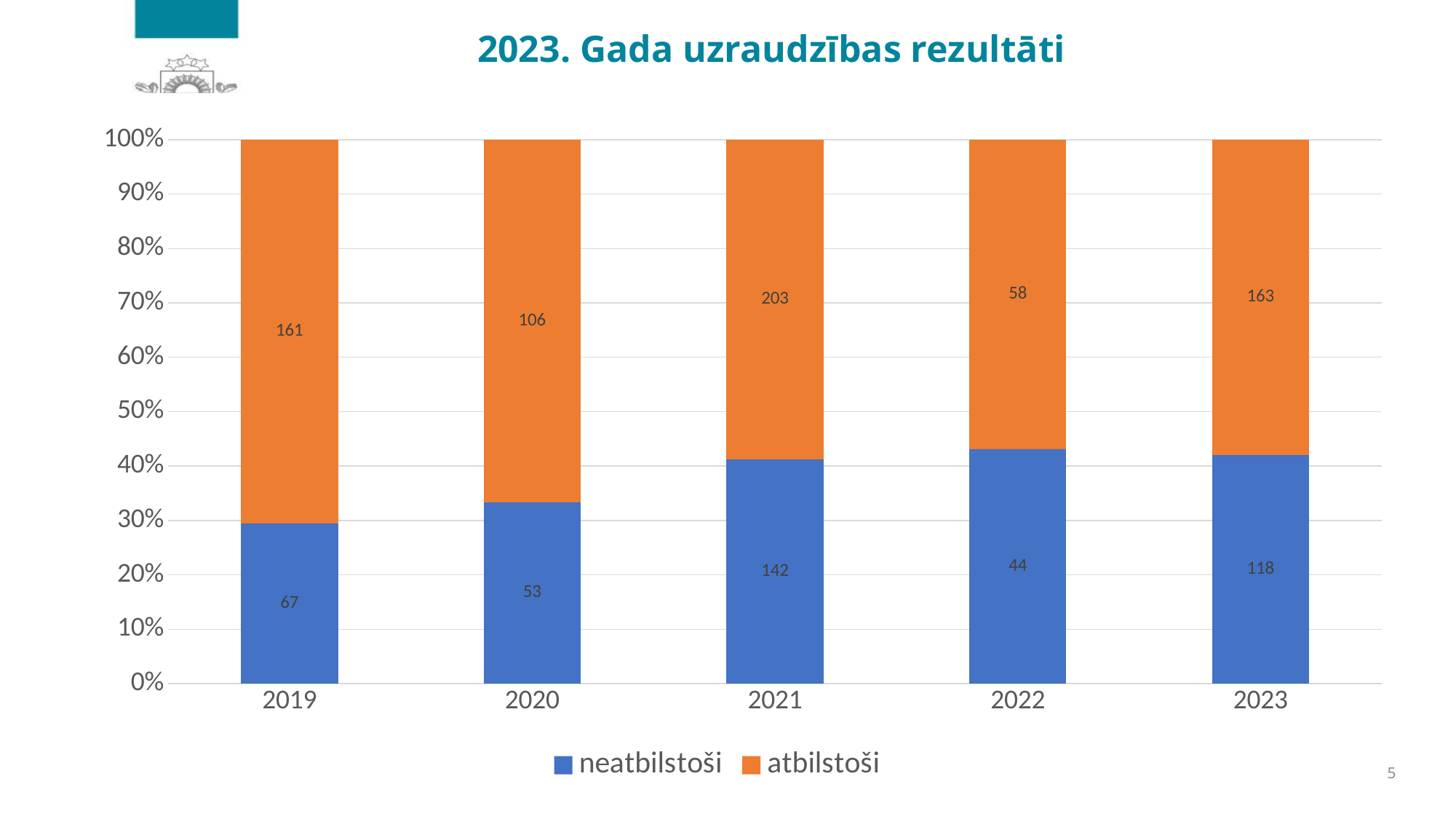
How many series does the legend list? 2 In which year is the neatbilstoši value lowest? 2022 How many years are shown on the x axis? 5 What is the value for atbilstoši in 2019? 161 What is the difference between the atbilstoši and neatbilstoši values in 2023? 45 In which year is the atbilstoši value highest? 2021 What is the value for neatbilstoši in 2023? 118 What is the total of the two values in the 2019 bar? 228 What is the value for neatbilstoši in 2021? 142 What kind of chart is shown on the slide? stacked bar chart Is the neatbilstoši share of the 2022 bar greater or less than 40%? greater Which is larger: the neatbilstoši value in 2021 or in 2023? 2021